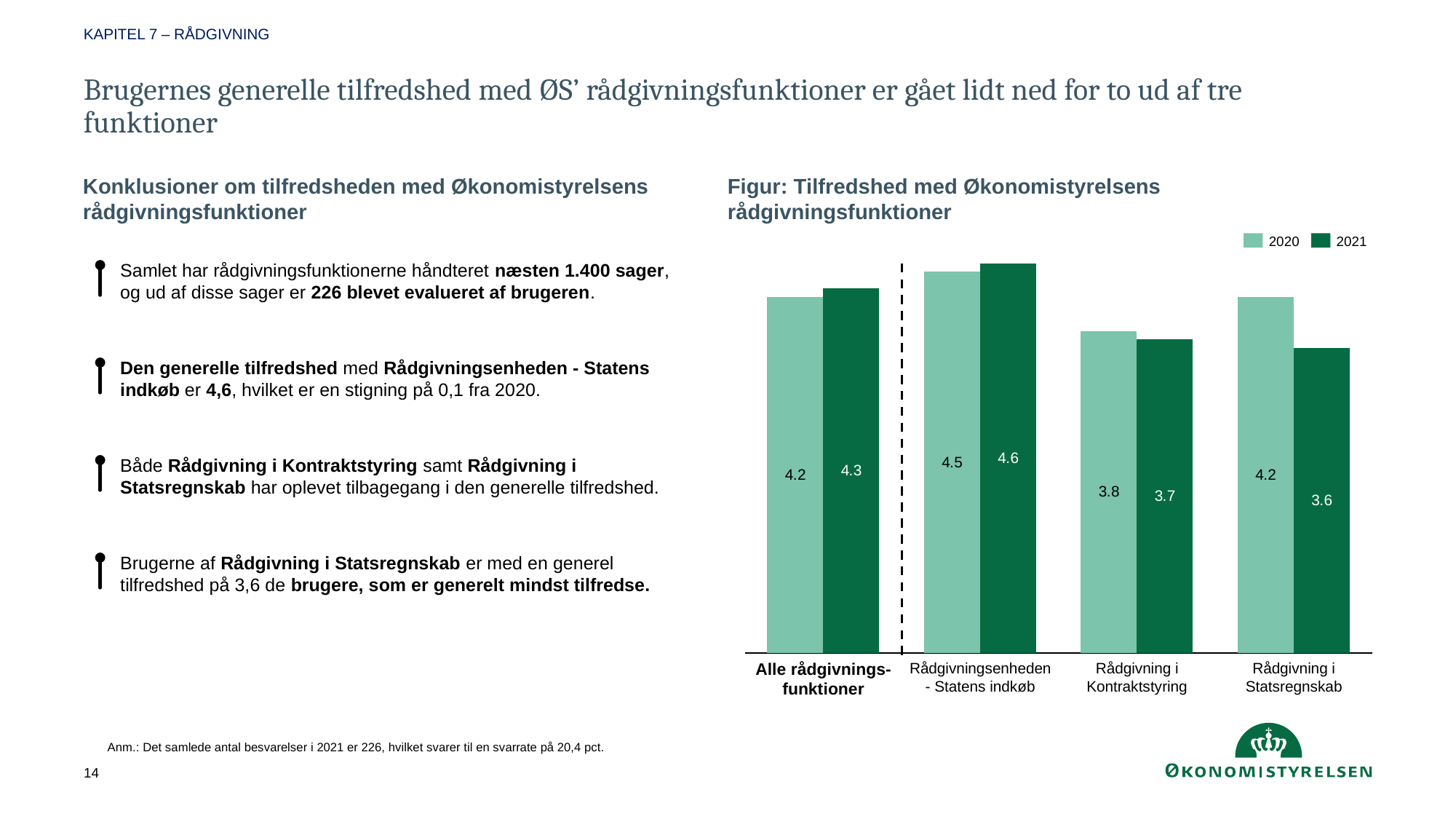
What type of chart is shown on the slide? bar chart What is the 2021 value for Rådgivningsenheden - Statens indkøb? 4.6 How many series does the legend list? 2 Which category has the lowest 2021 value? Rådgivning i Statsregnskab Which category has the lowest 2020 value? Rådgivning i Kontraktstyring What is the 2021 value for Rådgivning i Kontraktstyring? 3.7 Is the 2021 value for Rådgivning i Kontraktstyring larger or smaller than its 2020 value? smaller What is the 2020 value for Alle rådgivningsfunktioner? 4.2 What is the difference between the 2020 and 2021 values for Rådgivning i Statsregnskab? 0.6 How many categories are shown on the x axis of the chart? 4 Which category has the highest 2021 value? Rådgivningsenheden - Statens indkøb What is the 2020 value for Rådgivning i Statsregnskab? 4.2